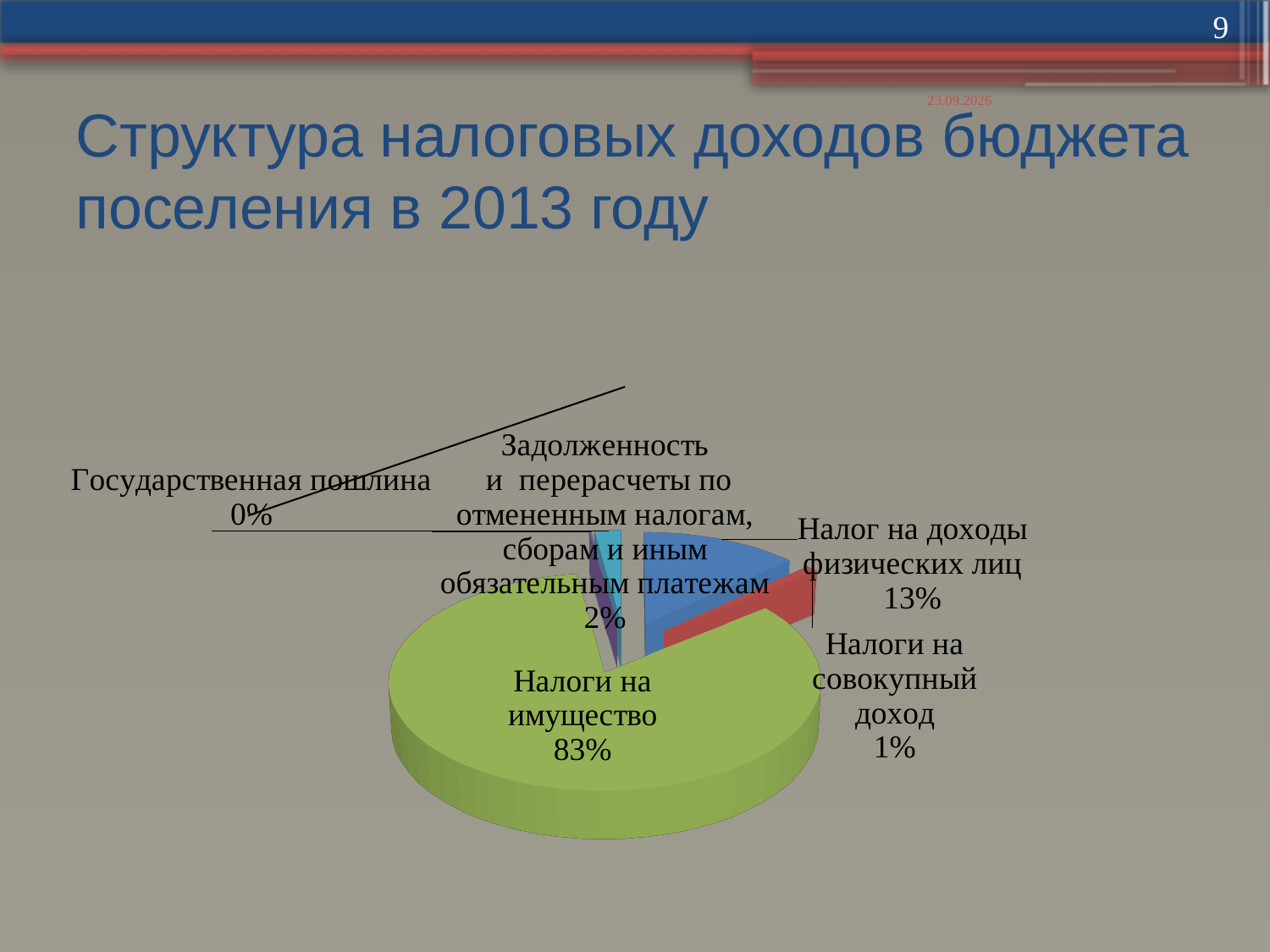
What kind of chart is shown on the slide? Pie chart What share of the pie does "Задолженность и перерасчеты по отмененным налогам, сборам и иным обязательным платежам" have? 2% What share of the pie does "Налоги на совокупный доход" have? 1% What share of the pie does "Государственная пошлина" have? 0% What is the difference in percentage points between "Налоги на имущество" and "Налог на доходы физических лиц"? 70 Which category has the largest share of the pie? Налоги на имущество What share of the pie does "Налоги на имущество" have? 83% What share of the pie does "Налог на доходы физических лиц" have? 13% What is the title of the slide containing the chart? Структура налоговых доходов бюджета поселения в 2013 году How many categories are shown in the pie chart? 5 Which is larger: the share for "Налог на доходы физических лиц" or the share for "Налоги на совокупный доход"? Налог на доходы физических лиц Which category has the smallest share of the pie? Государственная пошлина